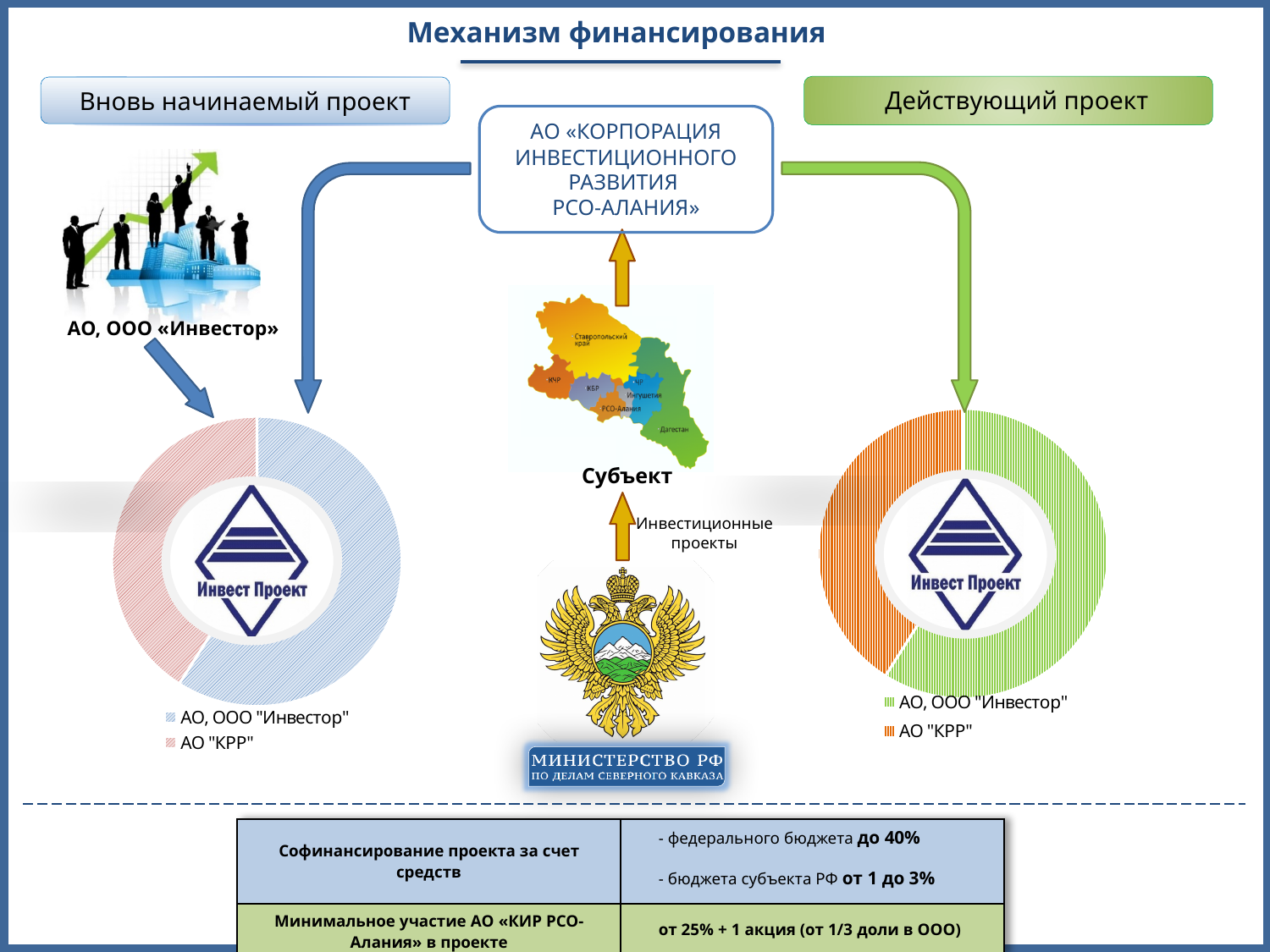
In the right chart ("Действующий проект"), what colour is the slice for АО "КРР"? Orange In the right chart ("Действующий проект"), which slice is larger: АО, ООО "Инвестор" or АО "КРР"? АО, ООО "Инвестор" How many entries does the legend of the right chart ("Действующий проект") list? 2 In the right chart ("Действующий проект"), which category has the largest slice? АО, ООО "Инвестор" In the left chart ("Вновь начинаемый проект"), which category has the smallest slice? АО "КРР" How many entries does the legend of the left chart ("Вновь начинаемый проект") list? 2 In the left chart ("Вновь начинаемый проект"), which slice is larger: АО, ООО "Инвестор" or АО "КРР"? АО, ООО "Инвестор" How many slices does the left chart ("Вновь начинаемый проект") have? 2 What are the two legend entries of the left chart ("Вновь начинаемый проект")? АО, ООО "Инвестор" and АО "КРР" How many slices does the right chart ("Действующий проект") have? 2 What kind of chart is shown under the heading "Действующий проект" on the right of the slide? Doughnut (pie) chart What kind of chart is shown under the heading "Вновь начинаемый проект" on the left of the slide? Doughnut (pie) chart